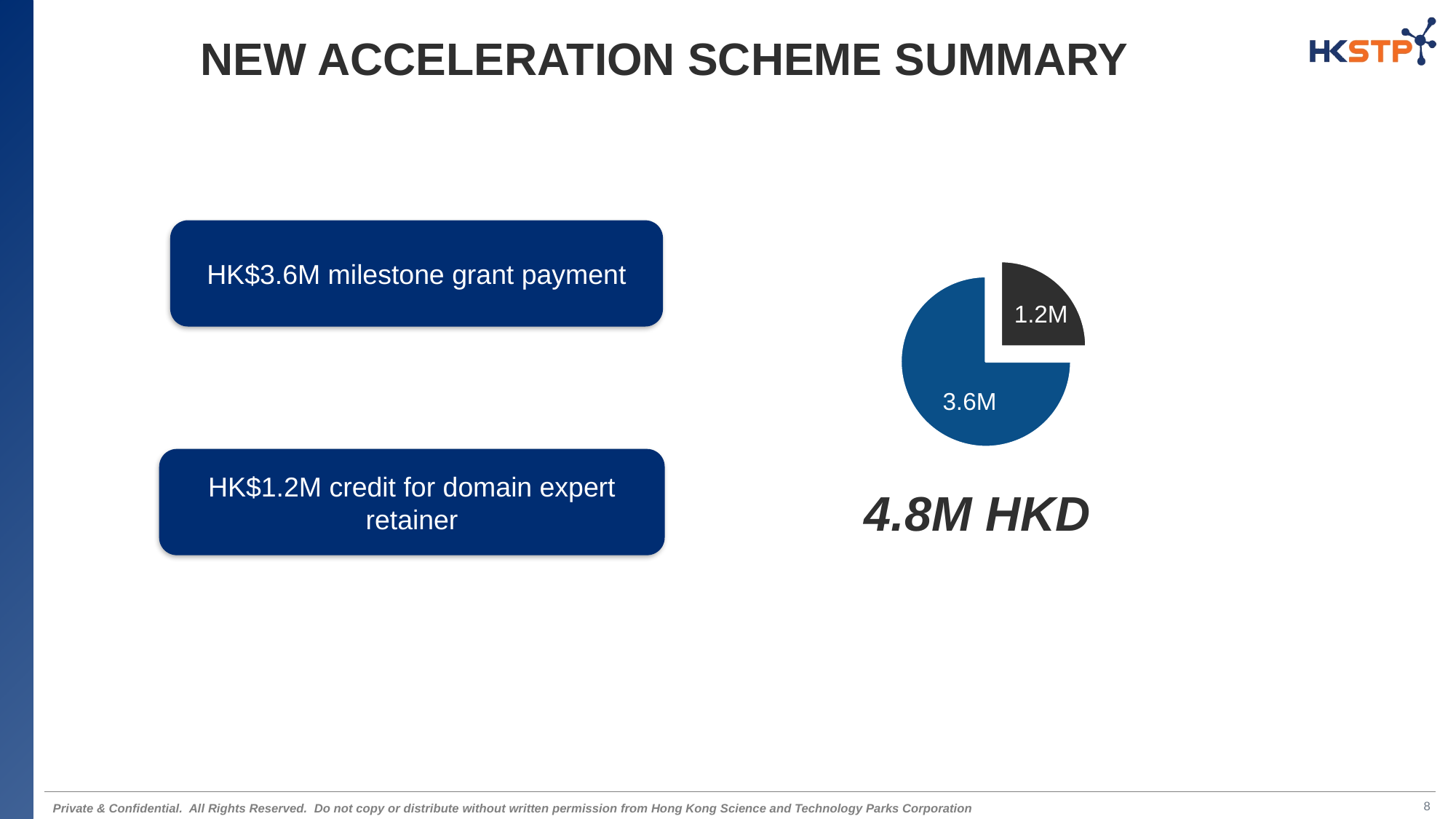
What is the value of the blue slice of the pie chart? 3.6M Which slice of the pie chart is the largest? 3.6M Which slice of the pie chart is the smallest? 1.2M What share of the pie does the 1.2M slice represent? 25% What is the value of the smaller slice of the pie chart? 1.2M Which slice of the pie chart is pulled out (exploded) from the rest of the pie? 1.2M What is the value of the larger slice of the pie chart? 3.6M What is the total of the two slices of the pie chart? 4.8M HKD What is the difference between the two slices of the pie chart? 2.4M How many slices does the pie chart have? 2 What is the value of the dark grey slice of the pie chart? 1.2M What kind of chart is shown on the slide? pie chart